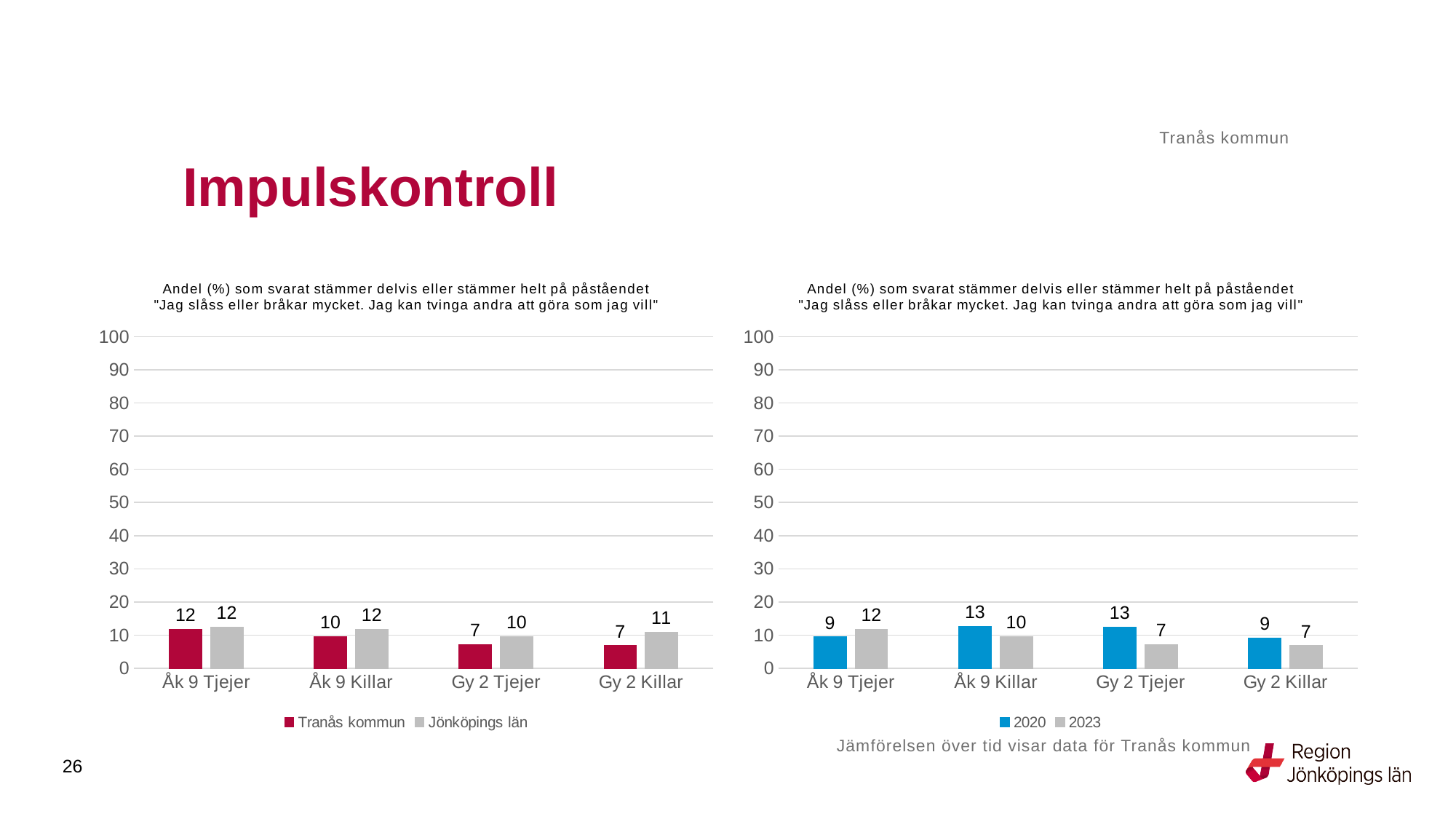
How many series does the legend of the right chart list? 2 In the left chart, what is the value for Jönköpings län for Gy 2 Killar? 11 In the right chart, which is larger for Åk 9 Killar, the 2020 value or the 2023 value? 2020 In the left chart, which category has the lowest value for Jönköpings län? Gy 2 Tjejer In the right chart, what is the difference between 2020 and 2023 for Gy 2 Tjejer? 6 In the right chart, what is the value for 2023 for Åk 9 Tjejer? 12 In the left chart, what is the value for Tranås kommun for Åk 9 Killar? 10 In the right chart, what is the value for 2020 for Gy 2 Tjejer? 13 In the left chart, what is the difference between Jönköpings län and Tranås kommun for Gy 2 Killar? 4 What type of chart is the left chart? Bar chart In the right chart, which category has the highest value for 2023? Åk 9 Tjejer How many categories are shown on the x axis of the left chart? 4